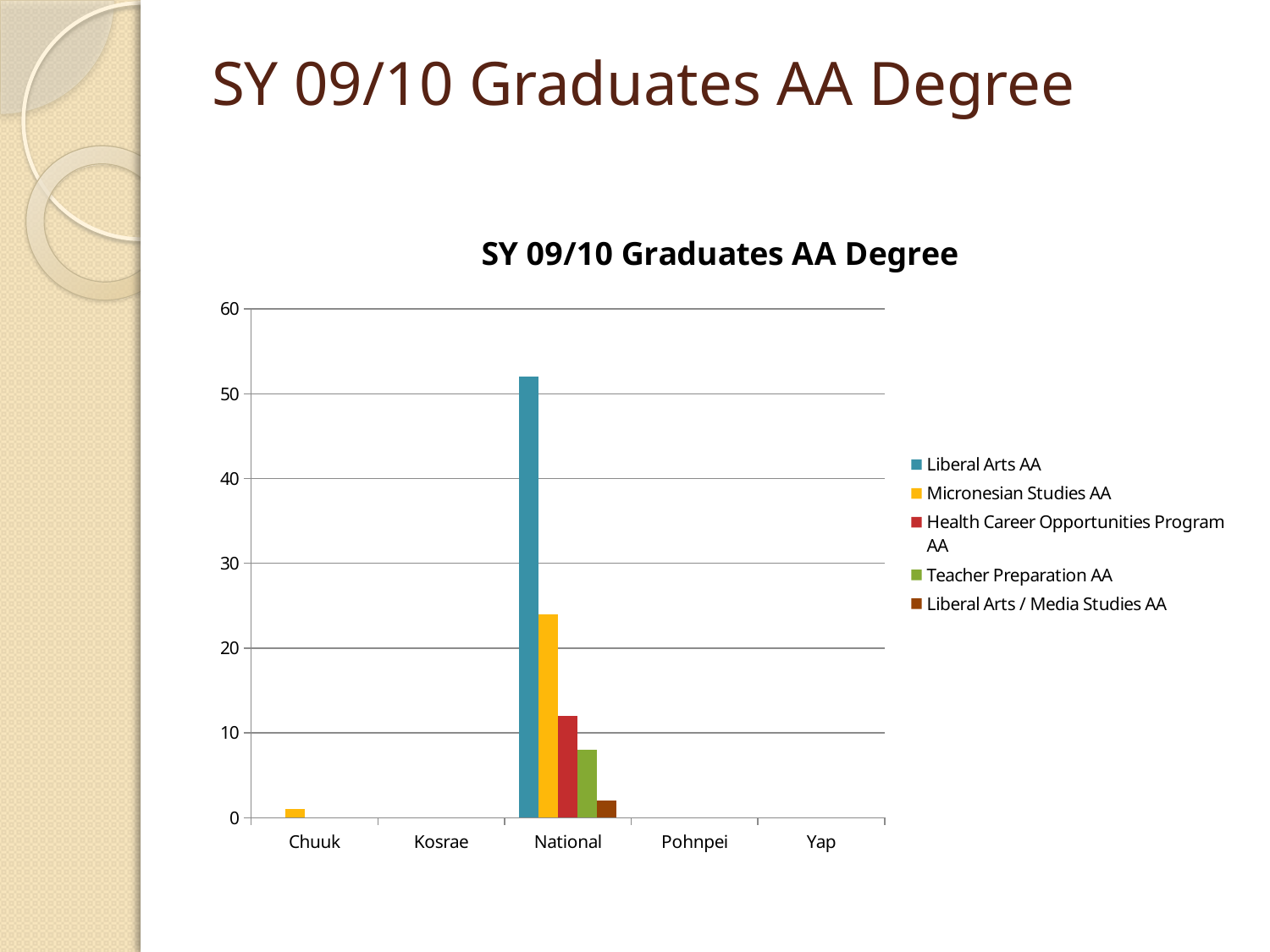
Is the Liberal Arts AA value for National greater or less than 40? greater Which series has the highest value for National? Liberal Arts AA Which category has the tallest bar in the chart? National Which series has the lowest value for National? Liberal Arts / Media Studies AA What kind of chart is shown on the slide? bar chart Which series is the only one with a visible bar for Chuuk? Micronesian Studies AA What is the title of the chart? SY 09/10 Graduates AA Degree How many series does the chart legend list? 5 For National, which is larger: Micronesian Studies AA or Health Career Opportunities Program AA? Micronesian Studies AA Is the Teacher Preparation AA value for National greater or less than 10? less How many categories are shown on the x axis of the chart? 5 Is the Micronesian Studies AA value for National greater or less than 20? greater